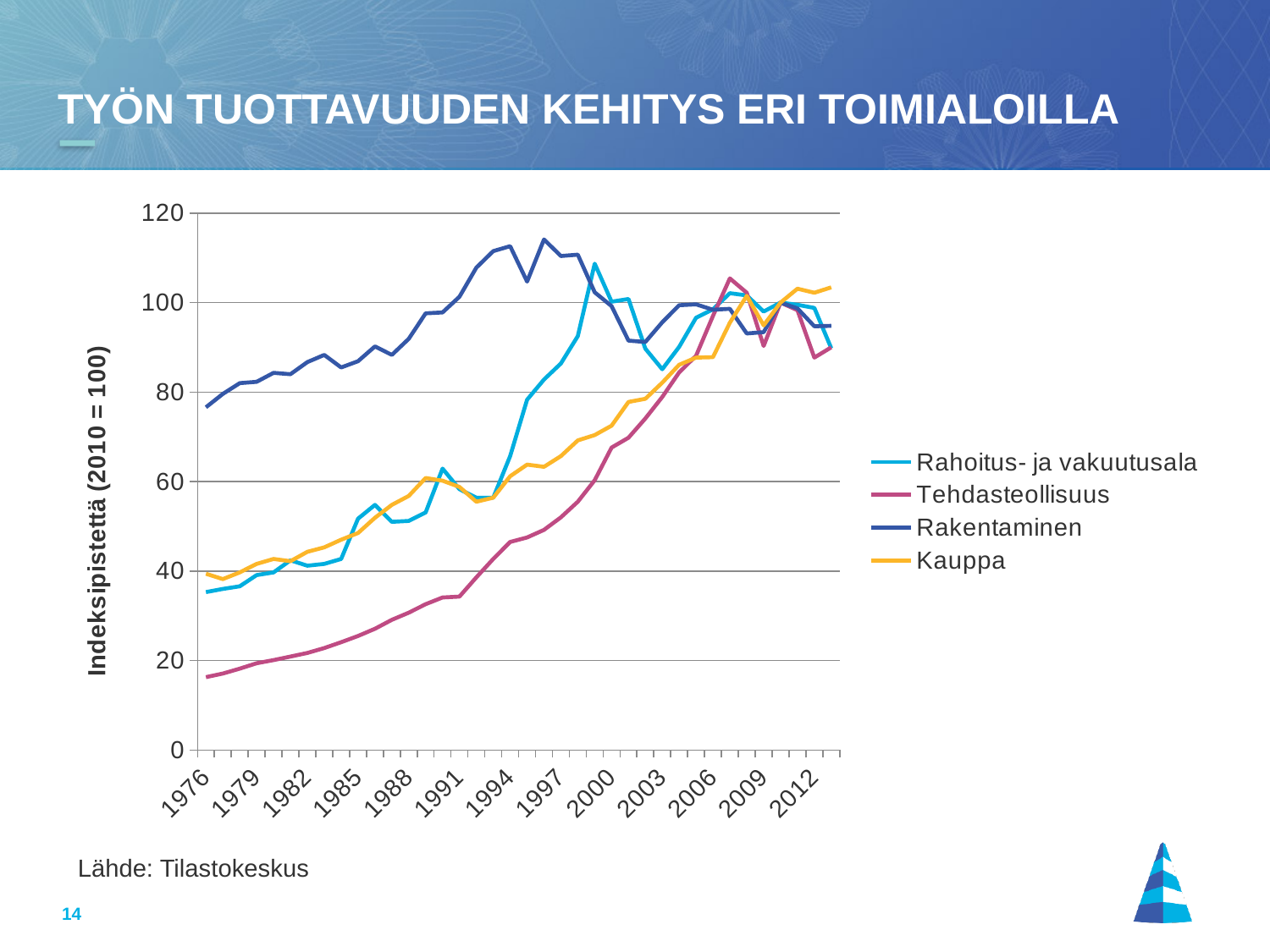
Does the Tehdasteollisuus series rise or fall from 1976 to 2006? rise Is the value for Rakentaminen in 1997 greater or less than 100? greater What kind of chart is shown on the slide? Line chart What is the label on the vertical axis? Indeksipistettä (2010 = 100) Which series has the highest value in 1976? Rakentaminen What is the title of the chart? TYÖN TUOTTAVUUDEN KEHITYS ERI TOIMIALOILLA Is the value for Tehdasteollisuus in 1976 greater or less than 20? less In 1991, which is larger: Rakentaminen or Kauppa? Rakentaminen Which series has the lowest value in 1976? Tehdasteollisuus Is the value for Rahoitus- ja vakuutusala in 1976 greater or less than 40? less How many series does the legend list? 4